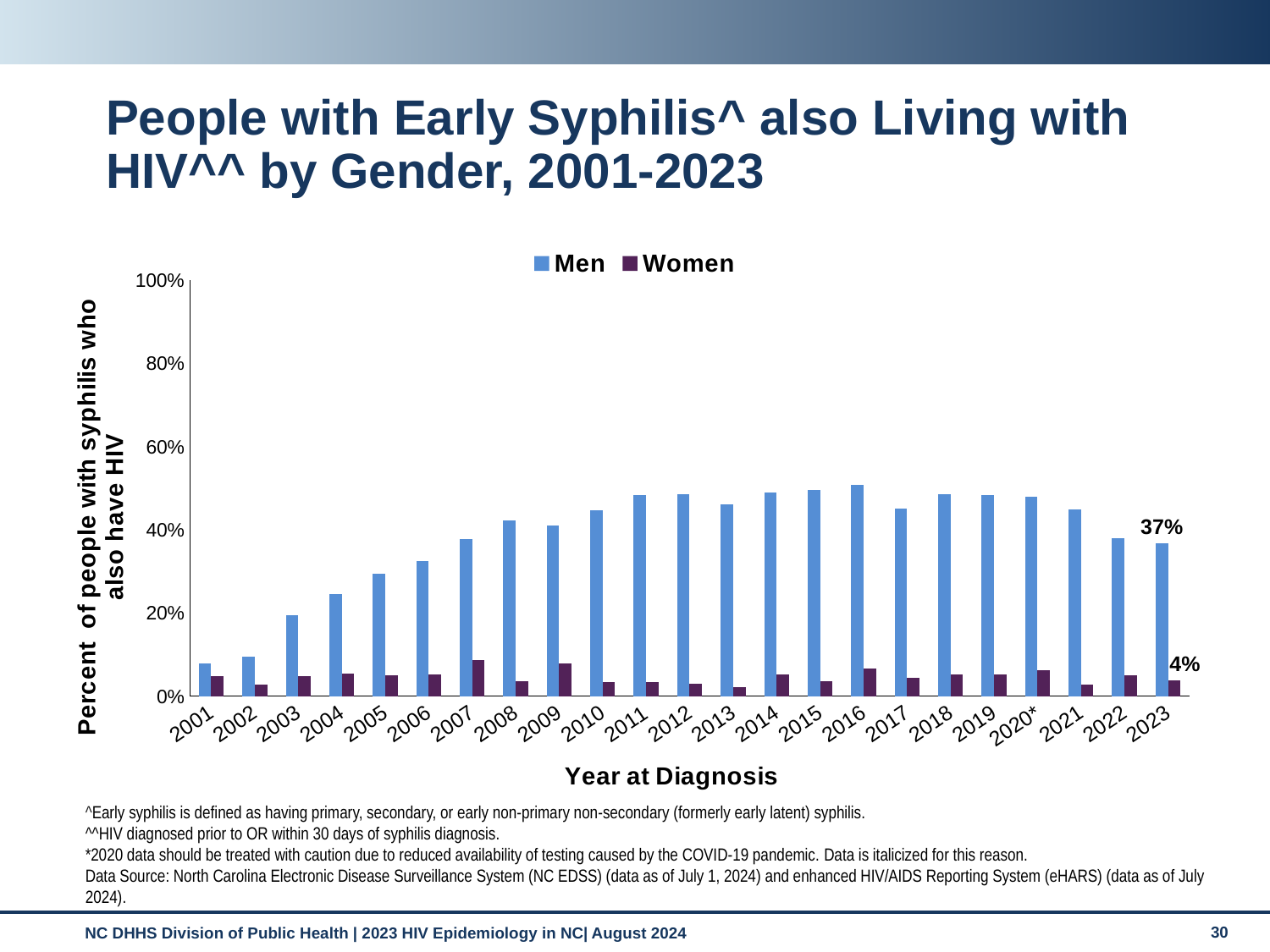
What is the difference between the Men and Women values in 2023? 33 percentage points Is the value for Men in 2016 greater or less than 40%? greater Is the value for Women in 2007 greater or less than 20%? less Is the value for Men in 2001 greater or less than 20%? less What is the value for Men in 2023? 37% What is the value for Women in 2023? 4% What is the title of the x axis? Year at Diagnosis In 2023, which series has the larger value, Men or Women? Men Do the values for Men generally rise or fall from 2001 to 2011? Rise What kind of chart is shown on the slide? Bar chart How many years are shown on the x axis? 23 How many series does the legend list? 2